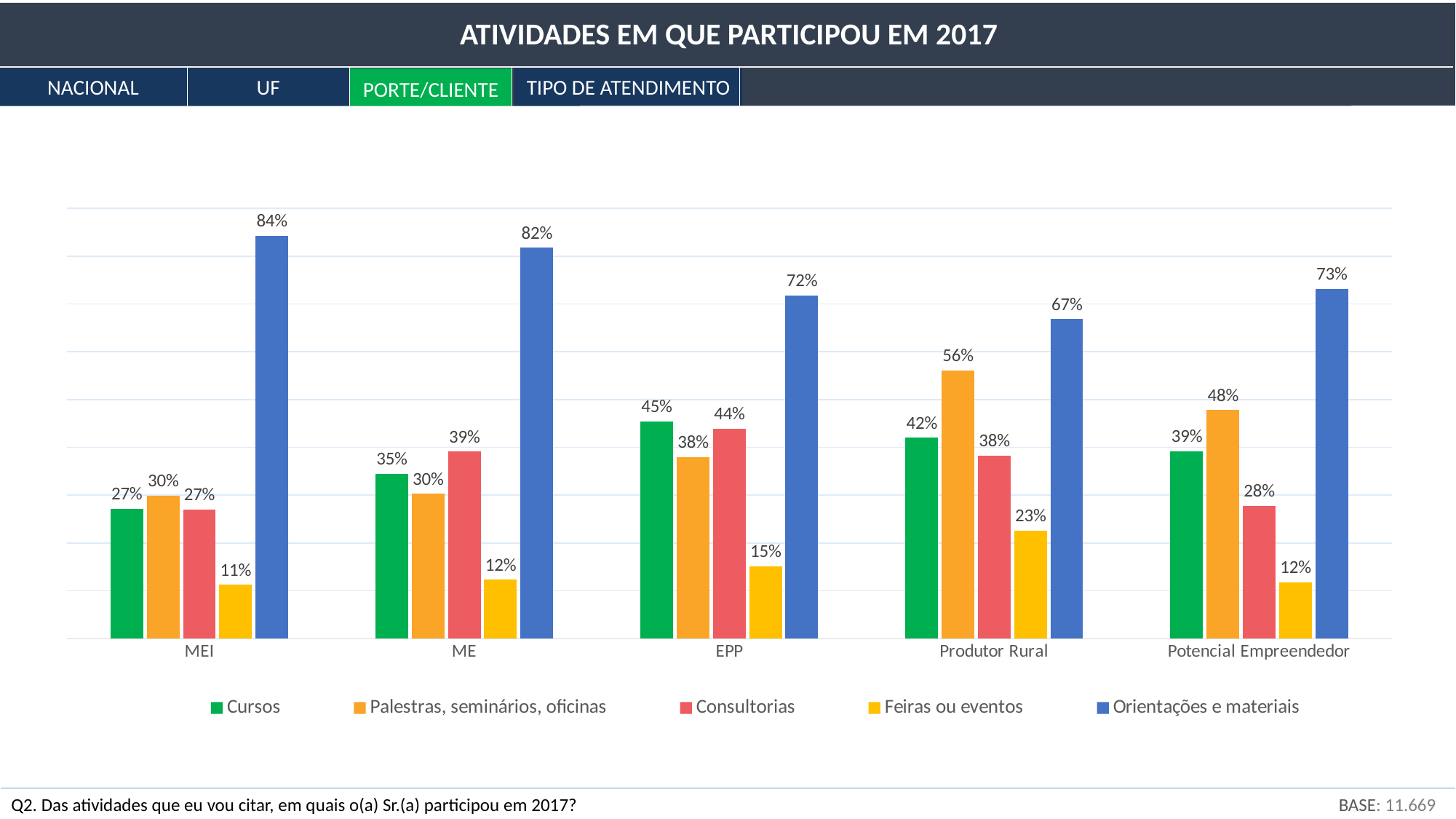
How many series does the legend list? 5 Which colour represents Feiras ou eventos in the legend? Yellow Which category has the highest value for Cursos? EPP What is the value for Feiras ou eventos in the EPP category? 15% What is the title of the chart? ATIVIDADES EM QUE PARTICIPOU EM 2017 Which is larger: Consultorias for ME or Consultorias for Potencial Empreendedor? ME What is the difference between Orientações e materiais for MEI and for Potencial Empreendedor? 11% Which category has the lowest value for Orientações e materiais? Produtor Rural What is the value for Orientações e materiais in the MEI category? 84% What is the value for Palestras, seminários, oficinas in the Produtor Rural category? 56% How many categories are shown on the x axis? 5 What kind of chart is shown on the slide? Bar chart